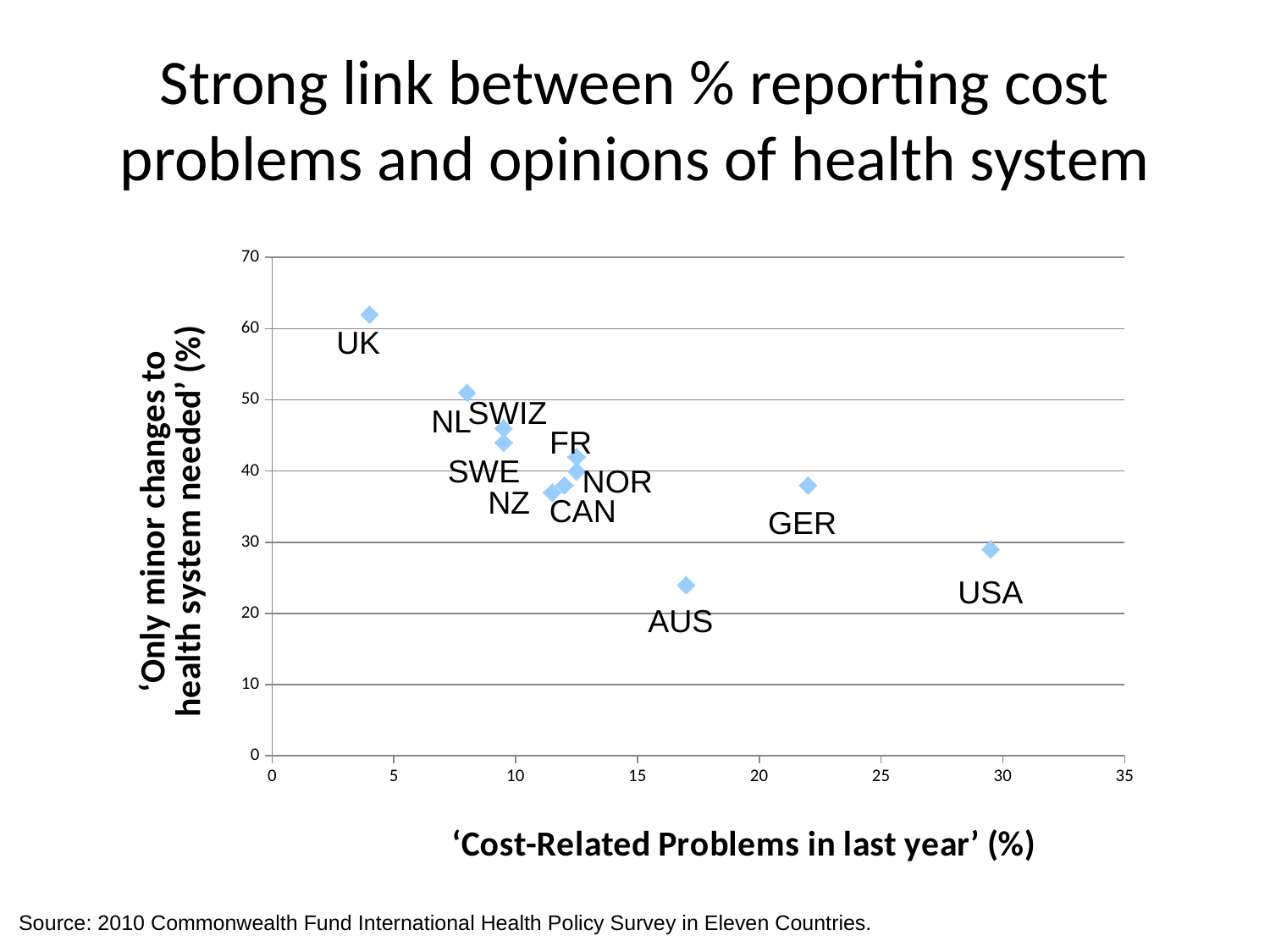
How many countries are plotted on the chart? 11 As 'Cost-Related Problems in last year' increases along the x axis, do the 'Only minor changes' values generally rise or fall? fall What kind of chart is shown on the slide? scatter chart Is the 'Cost-Related Problems in last year' value for USA greater or less than 25? greater Which country has the highest value for 'Only minor changes to health system needed' (%)? UK Which country has the highest value for 'Cost-Related Problems in last year' (%)? USA Which country has the lowest value for 'Only minor changes to health system needed' (%)? AUS What is the title of the x axis? 'Cost-Related Problems in last year' (%) Which country has a higher 'Only minor changes to health system needed' value, GER or USA? GER Is the 'Only minor changes to health system needed' value for AUS greater or less than 30? less Is the 'Only minor changes to health system needed' value for UK greater or less than 60? greater Which country has the lowest value for 'Cost-Related Problems in last year' (%)? UK